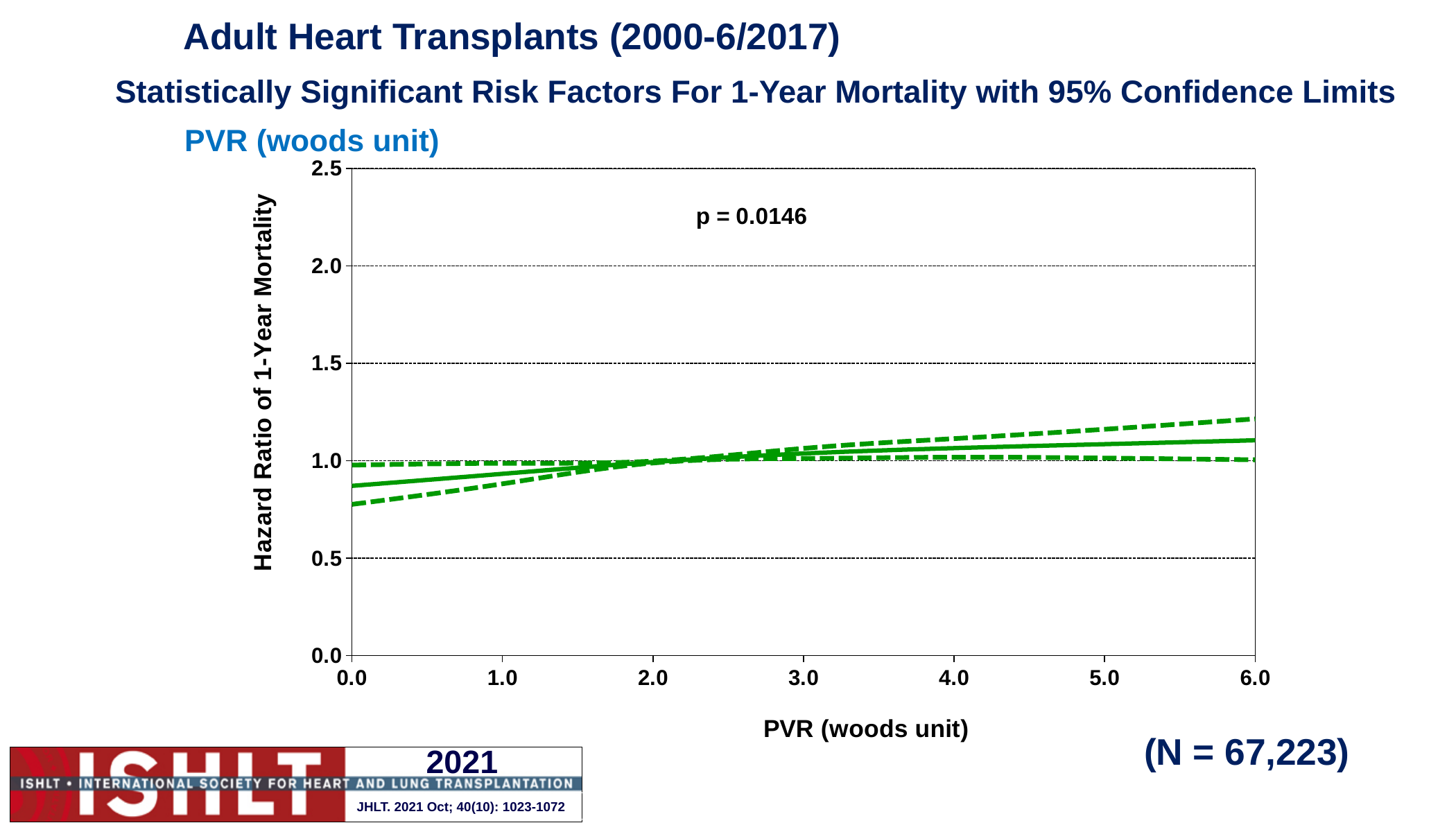
Is the lower 95% confidence limit at PVR 0.0 greater or less than 1.0? less What is the label of the y axis? Hazard Ratio of 1-Year Mortality Is the hazard ratio on the solid line at PVR 6.0 greater or less than 1.0? greater How many lines are plotted on the chart? 3 What sample size (N) is printed on the slide? N = 67,223 What kind of chart is shown on the slide? line chart Does the solid hazard ratio line rise or fall as PVR increases from 0.0 to 6.0? rise What p-value is printed on the chart? p = 0.0146 Is the upper 95% confidence limit at PVR 6.0 greater or less than 1.5? less What is the highest value shown on the y axis? 2.5